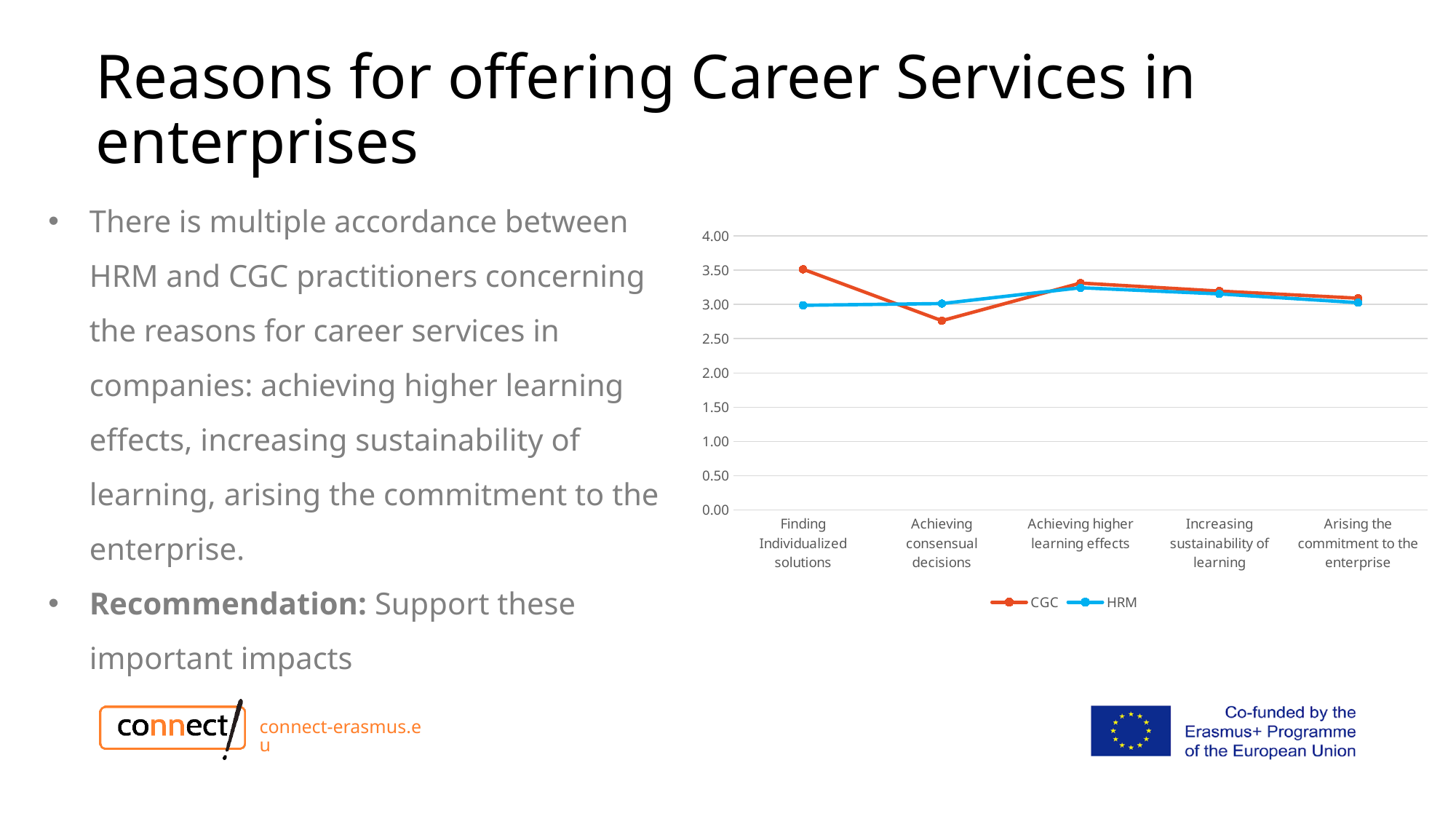
For which category is the CGC value lowest? Achieving consensual decisions Is the HRM value for Achieving higher learning effects greater or less than 3.00? greater Is the CGC value for Achieving consensual decisions greater or less than 3.00? less How many categories are shown on the x axis? 5 For which category is the CGC value highest? Finding Individualized solutions How many series does the legend list? 2 For Achieving consensual decisions, which series has the higher value, CGC or HRM? HRM For Finding Individualized solutions, which series has the higher value, CGC or HRM? CGC Which series are listed in the legend? CGC and HRM Is the CGC value for Finding Individualized solutions greater or less than 3.00? greater What kind of chart is shown on the slide? line chart What colour is the HRM line? blue